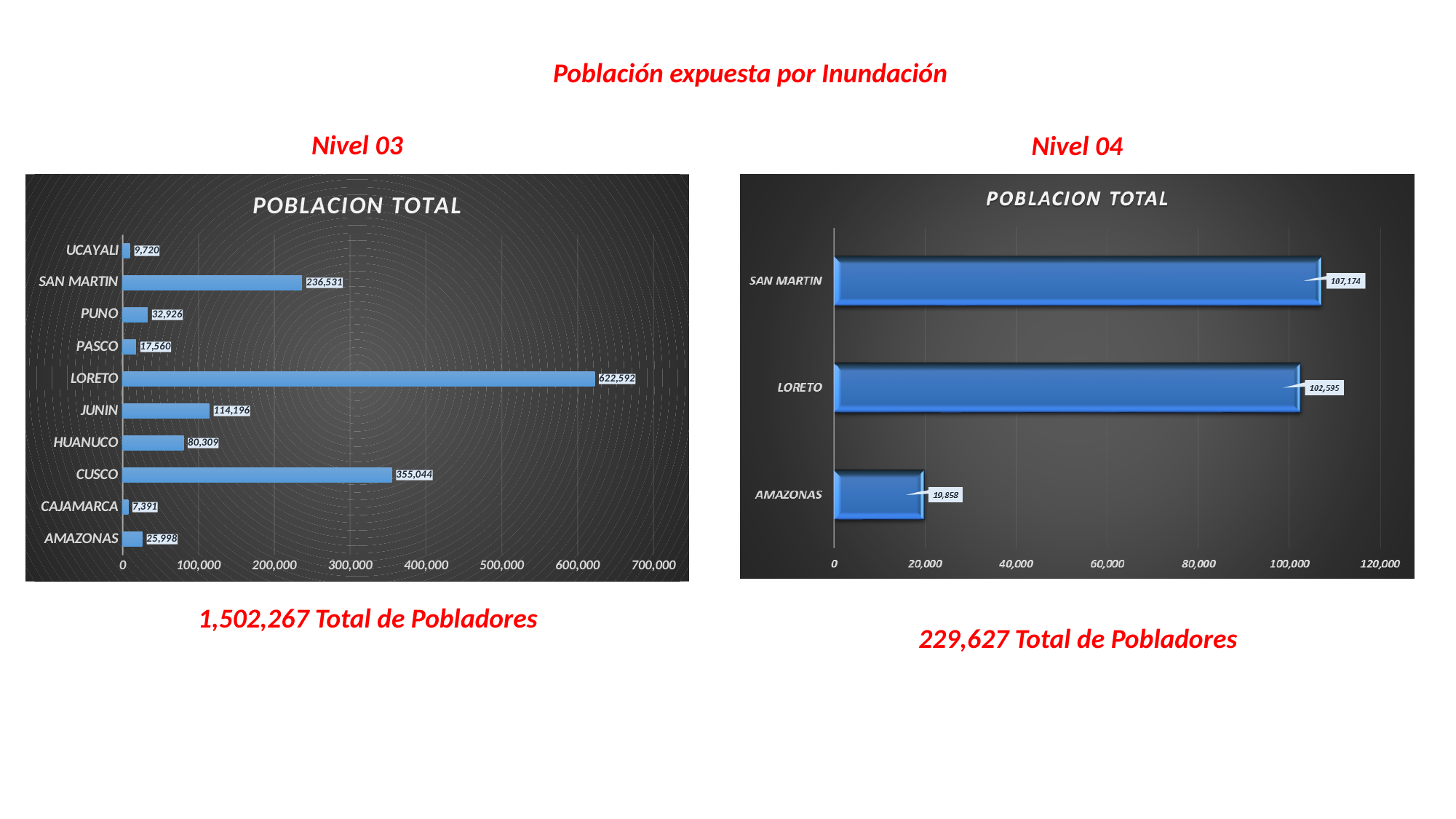
In the Nivel 03 chart (left), what is the difference between LORETO and CUSCO? 267,548 What type of chart is the Nivel 04 chart (right)? Bar chart In the Nivel 04 chart (right), which category has the highest value? SAN MARTIN In the Nivel 04 chart (right), what is the difference between SAN MARTIN and LORETO? 4,579 In the Nivel 04 chart (right), how many categories are shown? 3 In the Nivel 03 chart (left), which is larger, SAN MARTIN or JUNIN? SAN MARTIN In the Nivel 03 chart (left), what is the value for LORETO? 622,592 In the Nivel 04 chart (right), what is the value for AMAZONAS? 19,858 In the Nivel 03 chart (left), what is the value for CUSCO? 355,044 In the Nivel 03 chart (left), how many categories are shown? 10 In the Nivel 03 chart (left), which category has the lowest value? CAJAMARCA In the Nivel 03 chart (left), which category has the highest value? LORETO